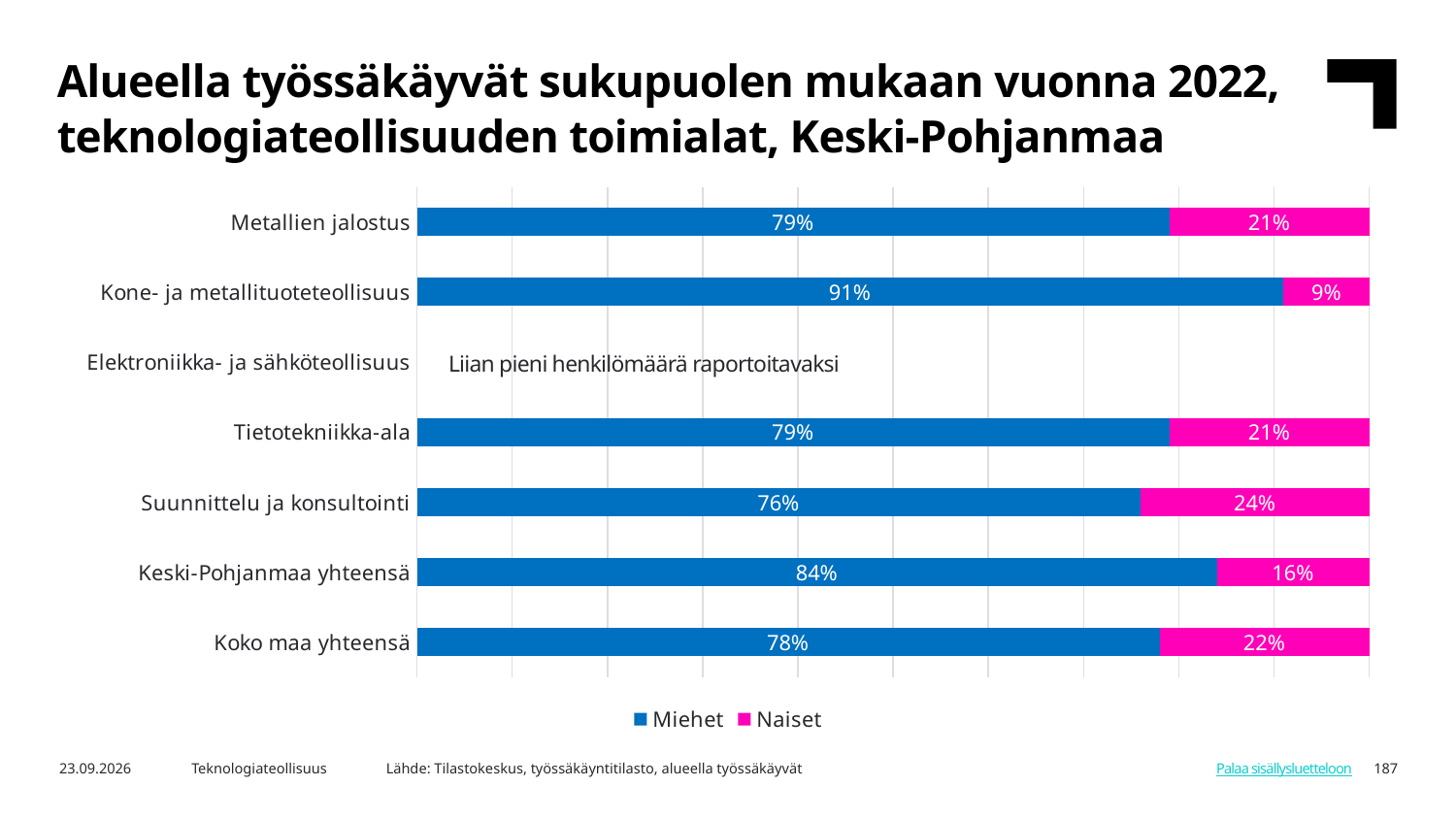
What is the Naiset share for Koko maa yhteensä? 22% What is the Naiset share for Suunnittelu ja konsultointi? 24% Which category has the highest Miehet share? Kone- ja metallituoteteollisuus What is the difference in the Miehet share between Keski-Pohjanmaa yhteensä and Koko maa yhteensä? 6 percentage points What text is shown instead of a bar for Elektroniikka- ja sähköteollisuus? Liian pieni henkilömäärä raportoitavaksi What is the Miehet share for Keski-Pohjanmaa yhteensä? 84% How many series does the legend list? 2 What kind of chart is shown on the slide? Stacked bar chart Which category has the lowest Naiset share? Kone- ja metallituoteteollisuus What is the total of the stacked bar for Tietotekniikka-ala? 100% What is the Miehet share for Kone- ja metallituoteteollisuus? 91% Which has a larger Naiset share, Metallien jalostus or Keski-Pohjanmaa yhteensä? Metallien jalostus